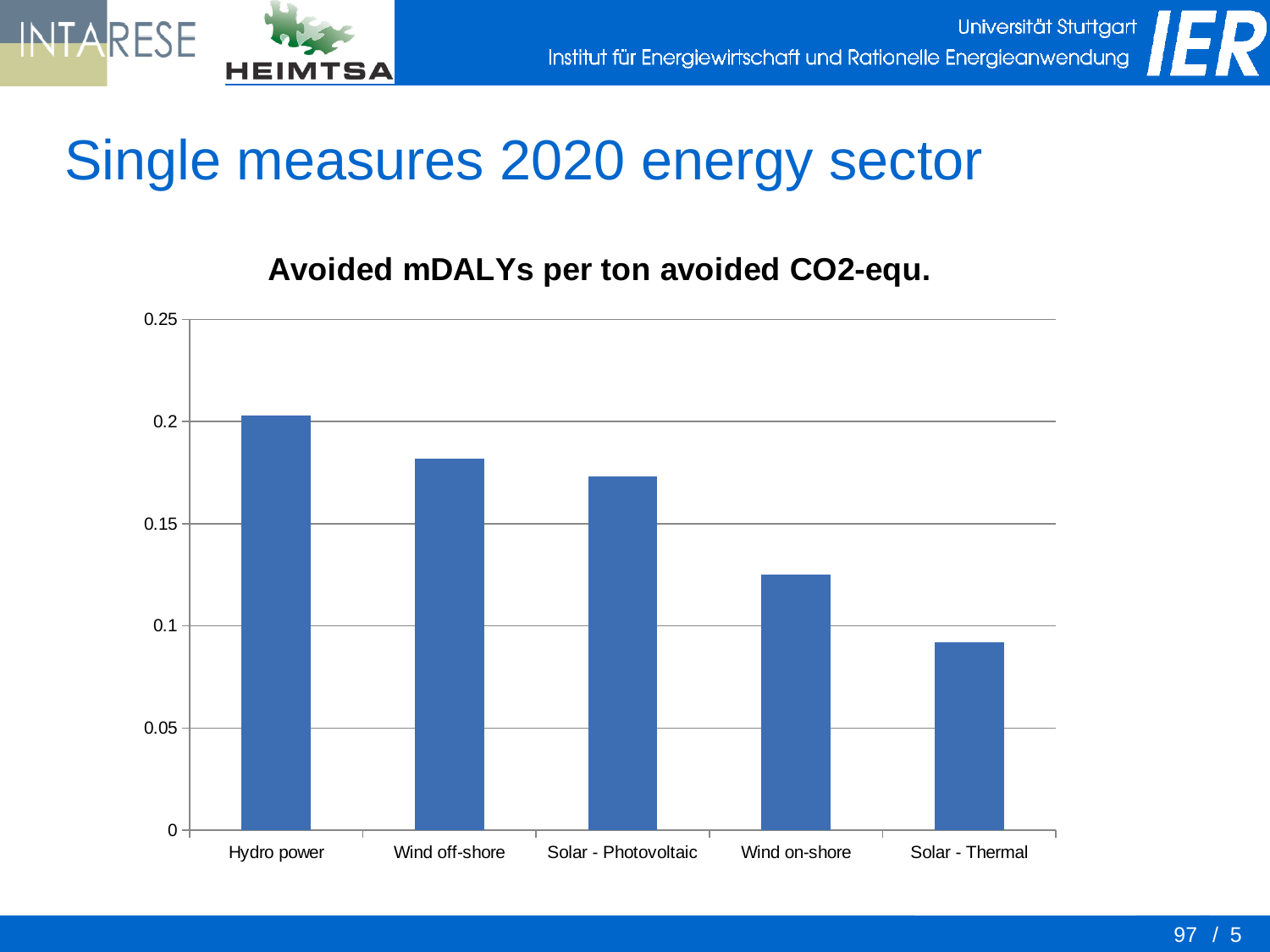
What is the title of the chart? Avoided mDALYs per ton avoided CO2-equ. Is the value for Wind off-shore greater or less than 0.2? less How many categories are shown on the x axis of the chart? 5 Which category has the highest value in the chart? Hydro power Which has a larger value, Wind off-shore or Wind on-shore? Wind off-shore Is the value for Solar - Thermal greater or less than 0.1? less Which has a larger value, Hydro power or Solar - Thermal? Hydro power What type of chart is shown on the slide? Bar chart Is the value for Wind on-shore greater or less than 0.15? less Which category has the lowest value in the chart? Solar - Thermal Do the values rise or fall from left to right along the x axis? fall